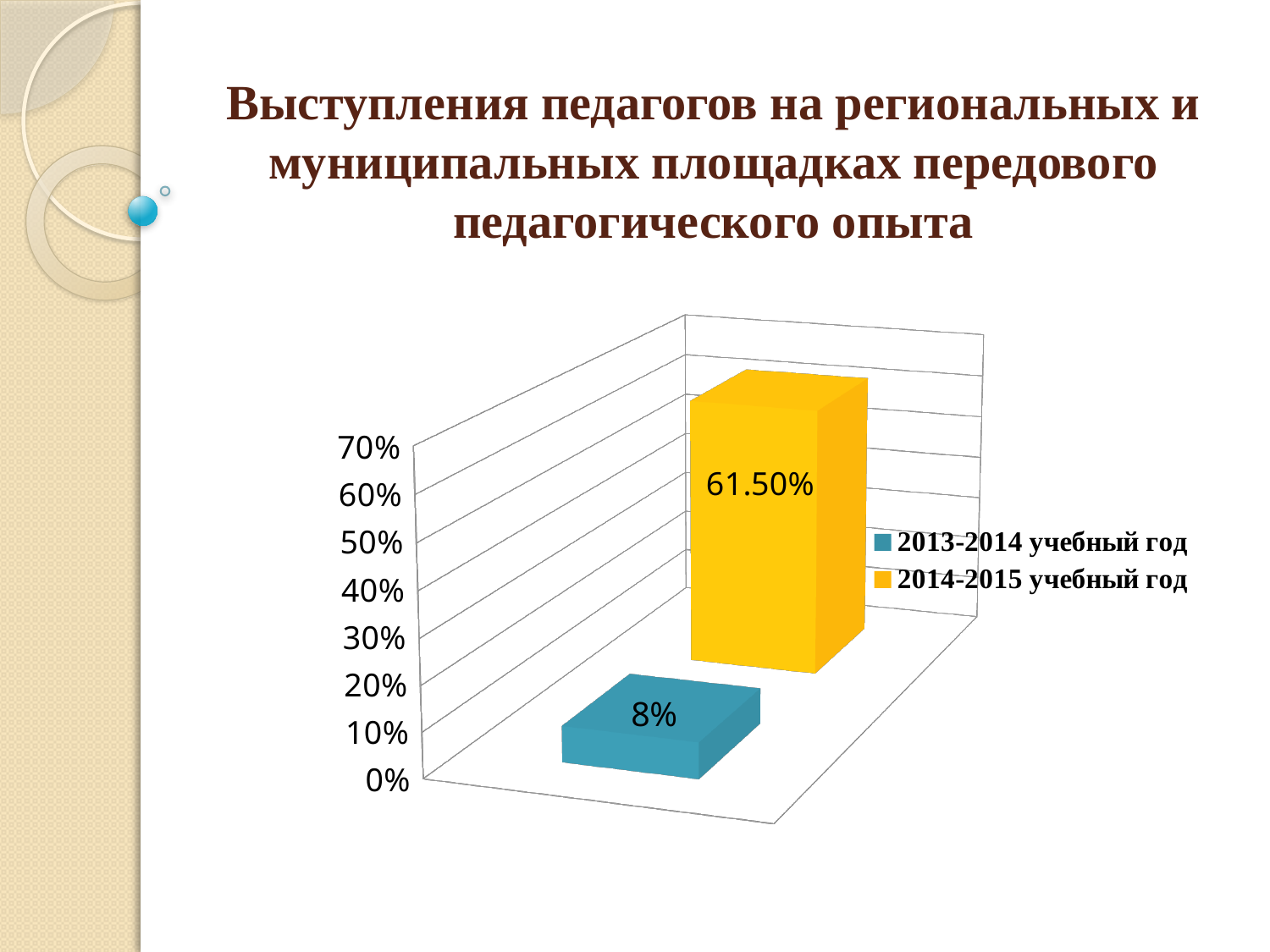
What kind of chart is shown on the slide? bar chart Is the value for 2013-2014 учебный год greater or less than 20%? less What colour is the bar for 2014-2015 учебный год? yellow What is the highest value shown on the vertical axis? 70% Which is larger: the value for 2013-2014 учебный год or for 2014-2015 учебный год? 2014-2015 учебный год What is the value for 2014-2015 учебный год? 61.50% Which series has the lowest value? 2013-2014 учебный год How many series does the legend list? 2 Is the value for 2014-2015 учебный год greater or less than 50%? greater Which series has the highest value? 2014-2015 учебный год What is the value for 2013-2014 учебный год? 8% What is the difference between the values for 2014-2015 учебный год and 2013-2014 учебный год? 53.50%